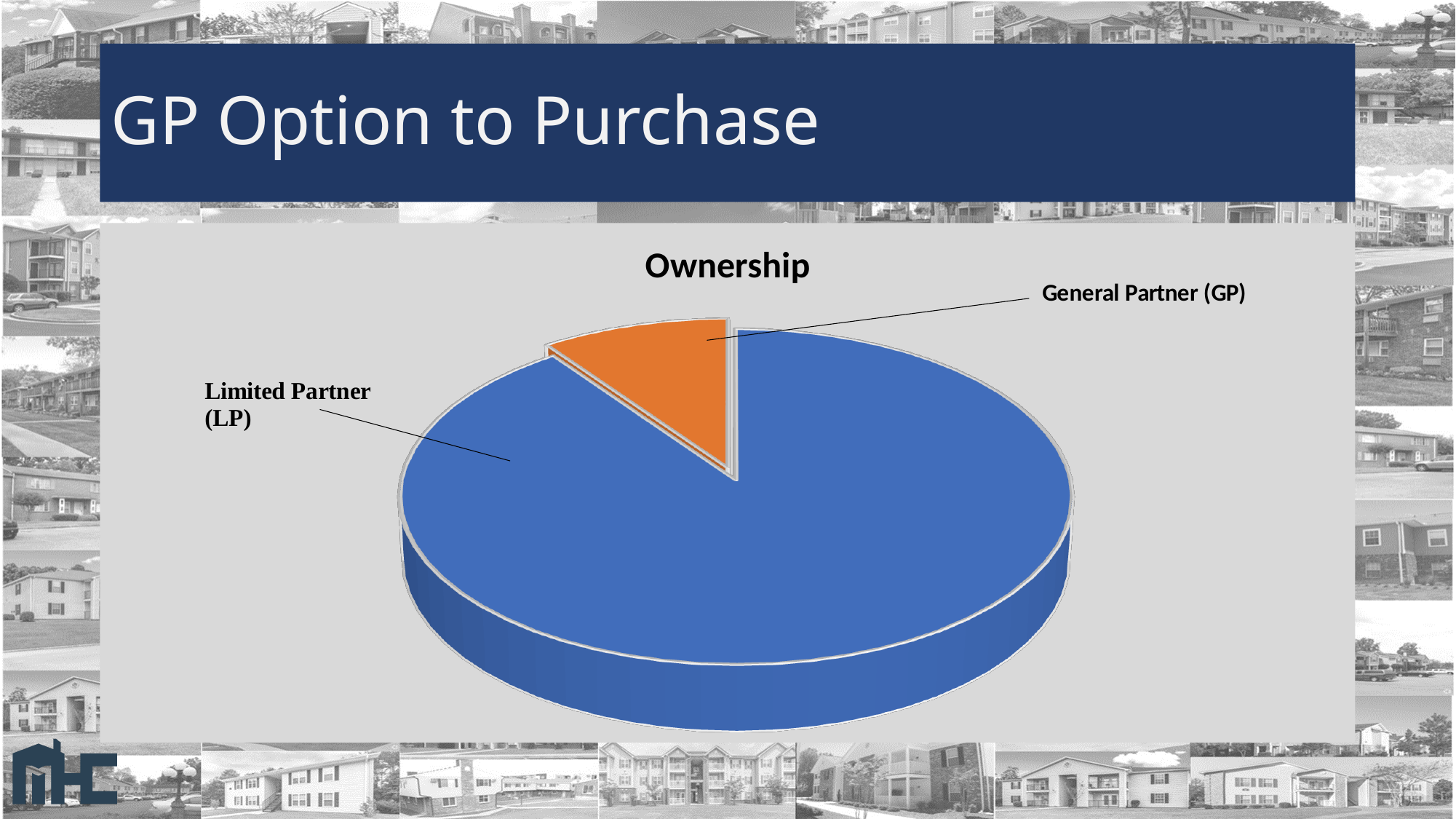
Which slice of the pie chart is the largest? Limited Partner (LP) What kind of chart is shown on the slide? pie chart What is the title of the chart? Ownership Which slice is shown in blue? Limited Partner (LP) What colour is the General Partner (GP) slice? orange Which has the larger share of ownership, the Limited Partner (LP) or the General Partner (GP)? Limited Partner (LP) Which slice of the pie chart is the smallest? General Partner (GP) How many slices does the pie chart have? 2